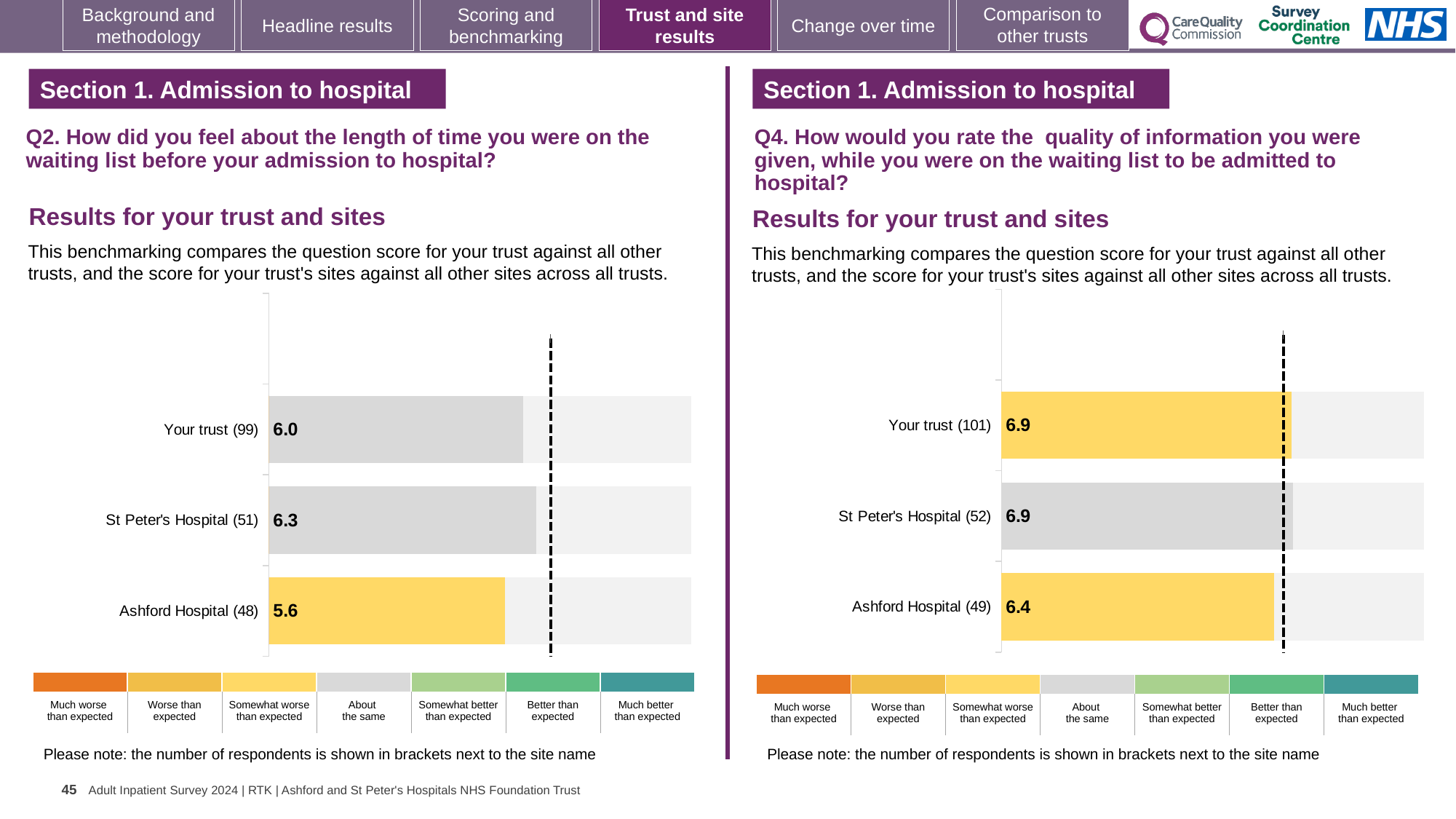
On the Q2 chart (left), what is the score for Ashford Hospital? 5.6 On the Q2 chart (left), what is the score for Your trust? 6.0 How many bars are plotted on the Q4 chart (right)? 3 On the Q4 chart (right), what is the score for Ashford Hospital? 6.4 On the Q2 chart (left), what is the difference between the scores for St Peter's Hospital and Ashford Hospital? 0.7 On the Q2 chart (left), how many respondents are shown for St Peter's Hospital? 51 On the Q2 chart (left), which site or trust has the highest score? St Peter's Hospital On the Q4 chart (right), what is the difference between the scores for Your trust and Ashford Hospital? 0.5 On the Q4 chart (right), which site or trust has the lowest score? Ashford Hospital On the Q2 chart (left), which site or trust has the lowest score? Ashford Hospital On the Q4 chart (right), what is the score for St Peter's Hospital? 6.9 What kind of chart is used on the Q2 chart (left)? Bar chart